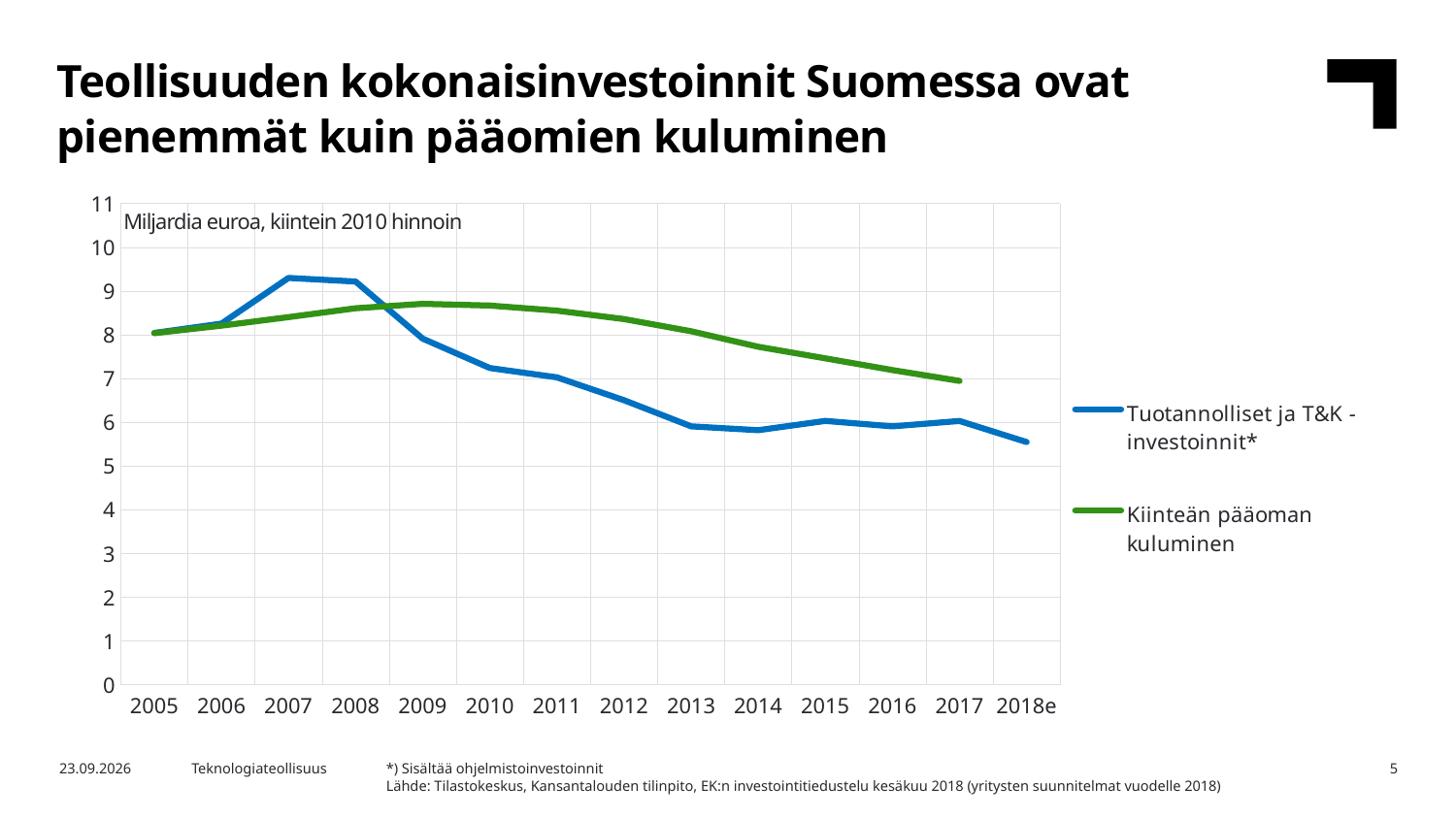
In which year is Tuotannolliset ja T&K -investoinnit* at its lowest? 2018e Is the value for Kiinteän pääoman kuluminen in 2017 greater or less than 8? less How many series does the legend list? 2 Is the value for Tuotannolliset ja T&K -investoinnit* in 2007 greater or less than 9? greater In 2013, which series has the higher value, Tuotannolliset ja T&K -investoinnit* or Kiinteän pääoman kuluminen? Kiinteän pääoman kuluminen Does the Kiinteän pääoman kuluminen line rise or fall from 2009 to 2017? fall Is the value for Kiinteän pääoman kuluminen in 2009 greater or less than 8? greater Does the Tuotannolliset ja T&K -investoinnit* line rise or fall from 2008 to 2013? fall What kind of chart is shown on the slide? line chart How many years are shown on the x axis? 14 What unit label is printed inside the chart area? Miljardia euroa, kiintein 2010 hinnoin